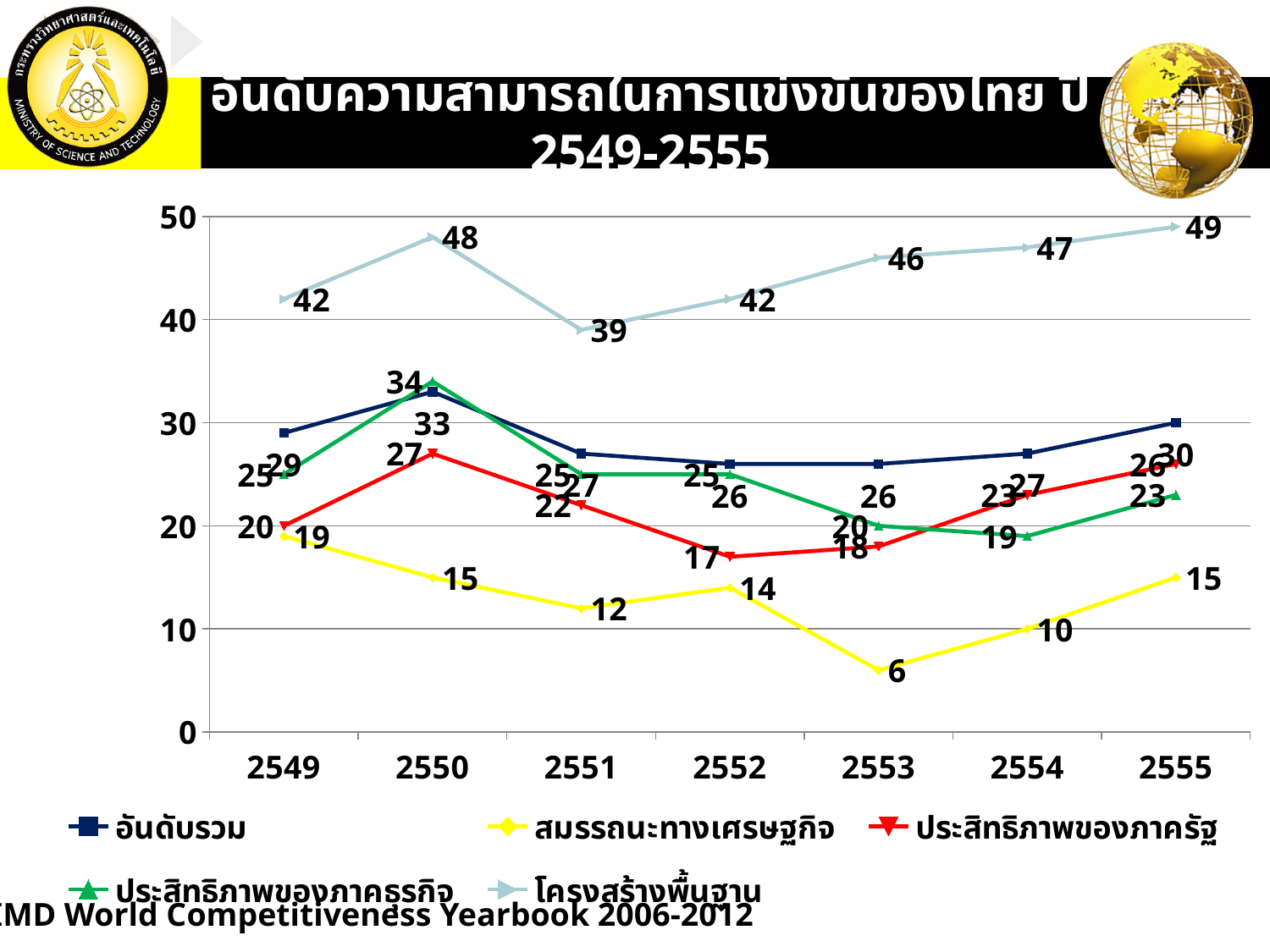
What is the value of ประสิทธิภาพของภาคธุรกิจ in 2550? 34 Does สมรรถนะทางเศรษฐกิจ rise or fall from 2553 to 2555? rise Which is larger in 2554: ประสิทธิภาพของภาครัฐ or ประสิทธิภาพของภาคธุรกิจ? ประสิทธิภาพของภาครัฐ What is the value of โครงสร้างพื้นฐาน in 2555? 49 In which year is สมรรถนะทางเศรษฐกิจ highest? 2549 What type of chart is shown on the slide? line chart What is the value of ประสิทธิภาพของภาครัฐ in 2552? 17 In which year is โครงสร้างพื้นฐาน lowest? 2551 What is the value of สมรรถนะทางเศรษฐกิจ in 2553? 6 How many series does the legend list? 5 What is the difference between โครงสร้างพื้นฐาน in 2550 and in 2551? 9 How many years are plotted along the x axis? 7